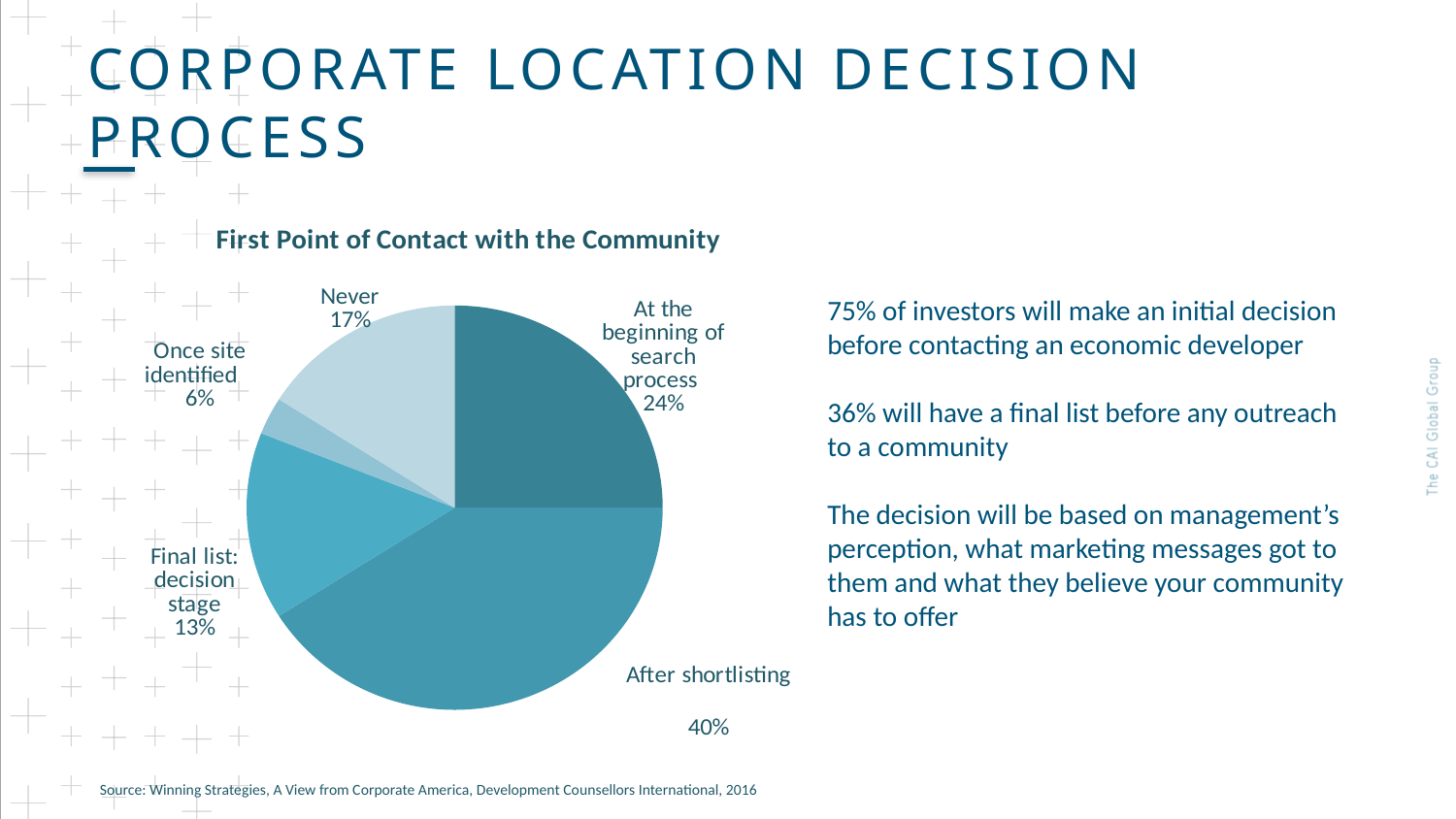
What percentage is shown for "At the beginning of search process"? 24% Which is larger, the share for "Never" or the share for "Final list: decision stage"? Never What percentage is shown for "Final list: decision stage"? 13% Which slice of the pie is the smallest? Once site identified What share of the pie is labelled "After shortlisting"? 40% What is the title of the chart? First Point of Contact with the Community What is the difference in percentage points between "After shortlisting" and "At the beginning of search process"? 16 What percentage is shown for "Never"? 17% What kind of chart is shown on the slide? Pie chart Which slice of the pie is the largest? After shortlisting How many slices does the pie chart have? 5 What percentage is shown for "Once site identified"? 6%